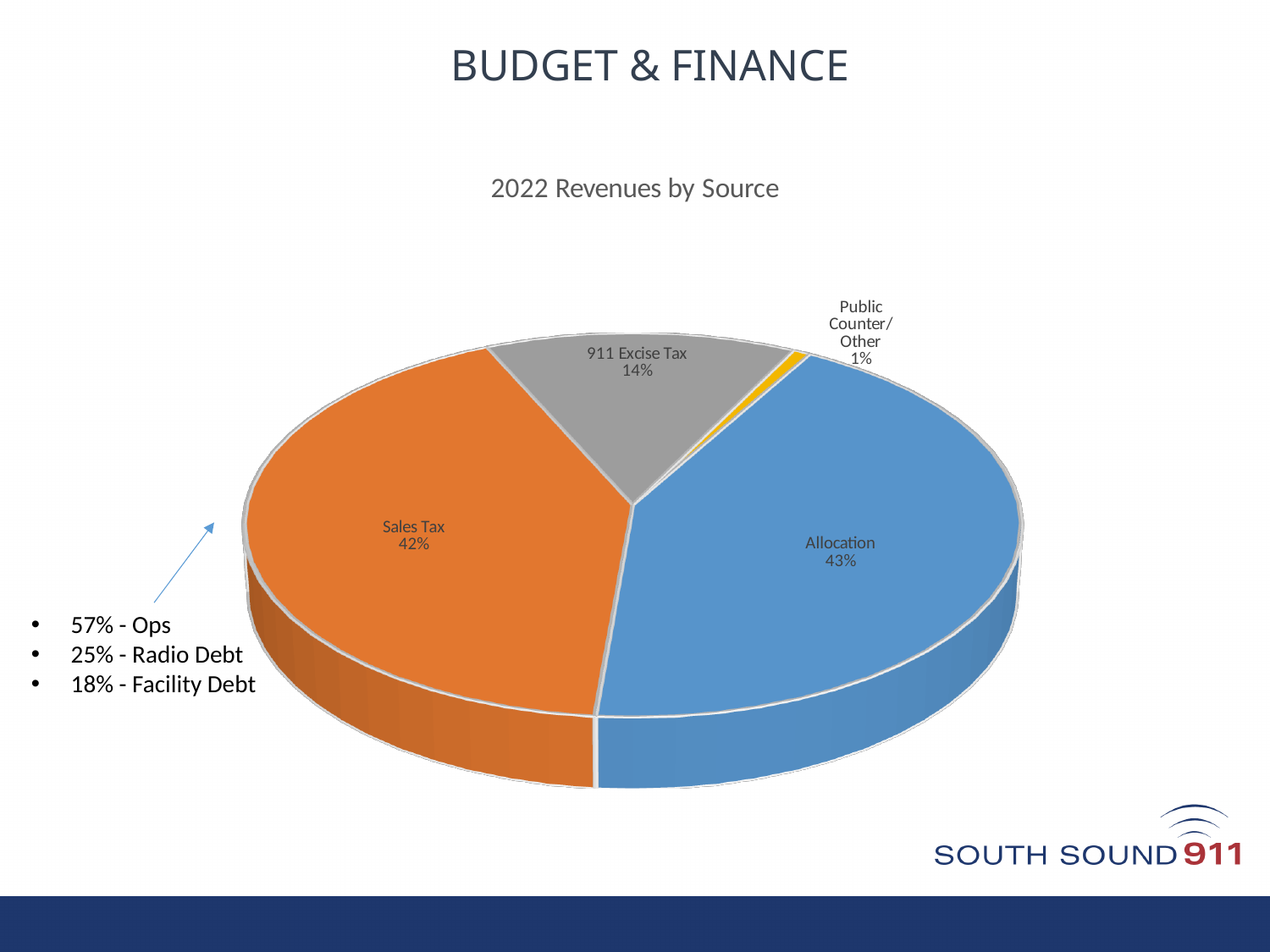
What is the difference in percentage points between the Allocation and Sales Tax shares? 1% What share of 2022 revenues comes from Allocation? 43% Which is larger, the share for 911 Excise Tax or the share for Public Counter/Other? 911 Excise Tax What share of 2022 revenues comes from Sales Tax? 42% What share of 2022 revenues comes from Public Counter/Other? 1% Which revenue source has the largest share of 2022 revenues? Allocation What kind of chart is shown on the slide? Pie chart What is the title of the chart? 2022 Revenues by Source What is the difference in percentage points between the Sales Tax and 911 Excise Tax shares? 28% Which revenue source has the smallest share of 2022 revenues? Public Counter/Other How many revenue sources are shown in the pie chart? 4